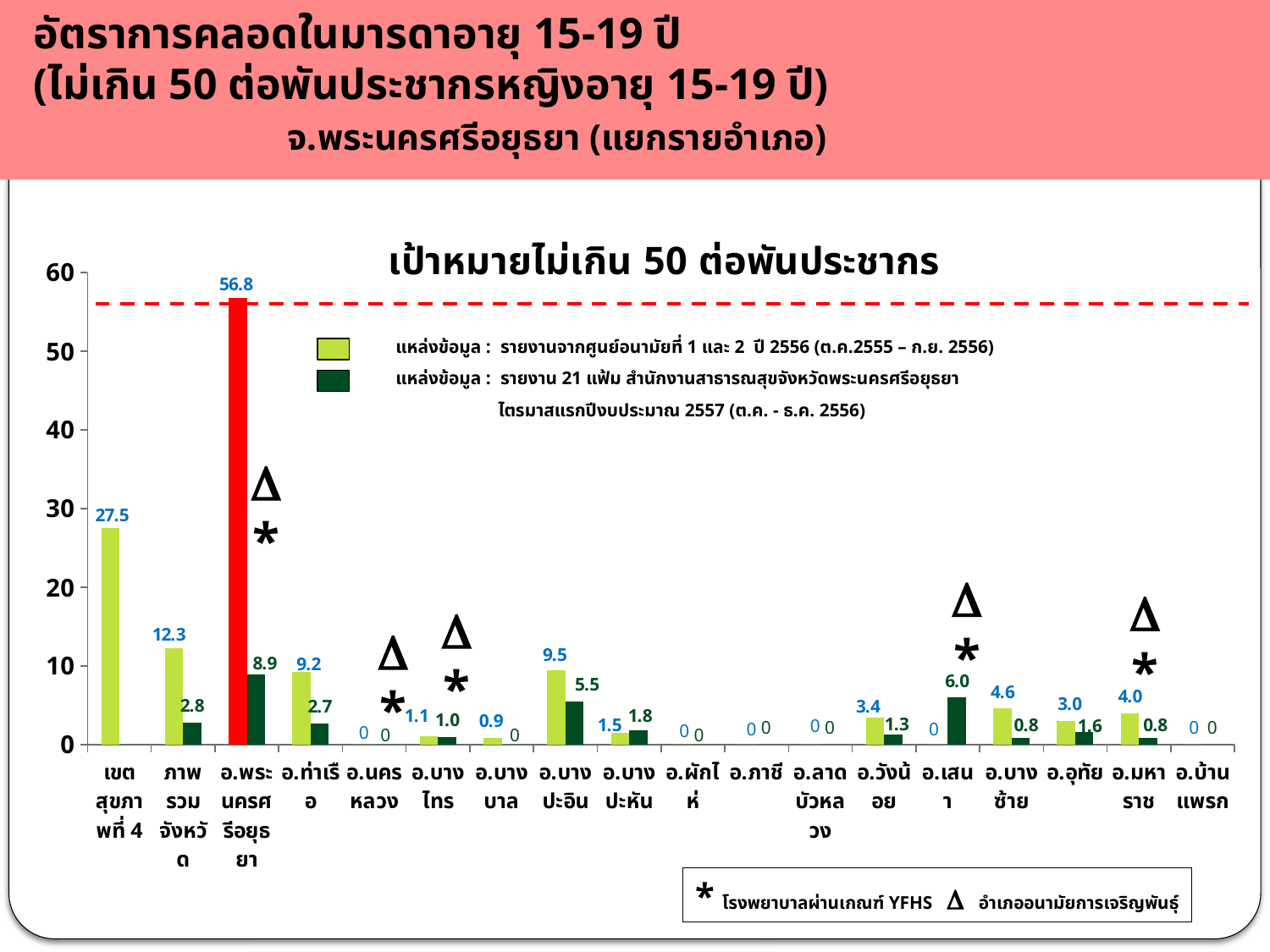
Is the light green (ปี 2556) value for อ.พระนครศรีอยุธยา greater or less than 50? greater What is the value of the light green (ปี 2556) bar for อ.พระนครศรีอยุธยา? 56.8 Which district has the highest value in the dark green (ไตรมาสแรกปีงบประมาณ 2557) series? อ.พระนครศรีอยุธยา Which is larger for อ.บางปะหัน: the light green (ปี 2556) bar or the dark green (ไตรมาสแรกปีงบประมาณ 2557) bar? dark green (1.8) How many categories are shown on the x axis? 18 What is the difference between the light green and dark green bars for ภาพรวมจังหวัด? 9.5 Which district has the highest value in the light green (ปี 2556) series? อ.พระนครศรีอยุธยา What is the value of the dark green (ไตรมาสแรกปีงบประมาณ 2557) bar for อ.ท่าเรือ? 2.7 How many data series does the legend list? 2 What kind of chart is shown on the slide? bar chart What is the value of the light green (ปี 2556) bar for เขตสุขภาพที่ 4? 27.5 What is the value of the dark green (ไตรมาสแรกปีงบประมาณ 2557) bar for อ.บางปะอิน? 5.5